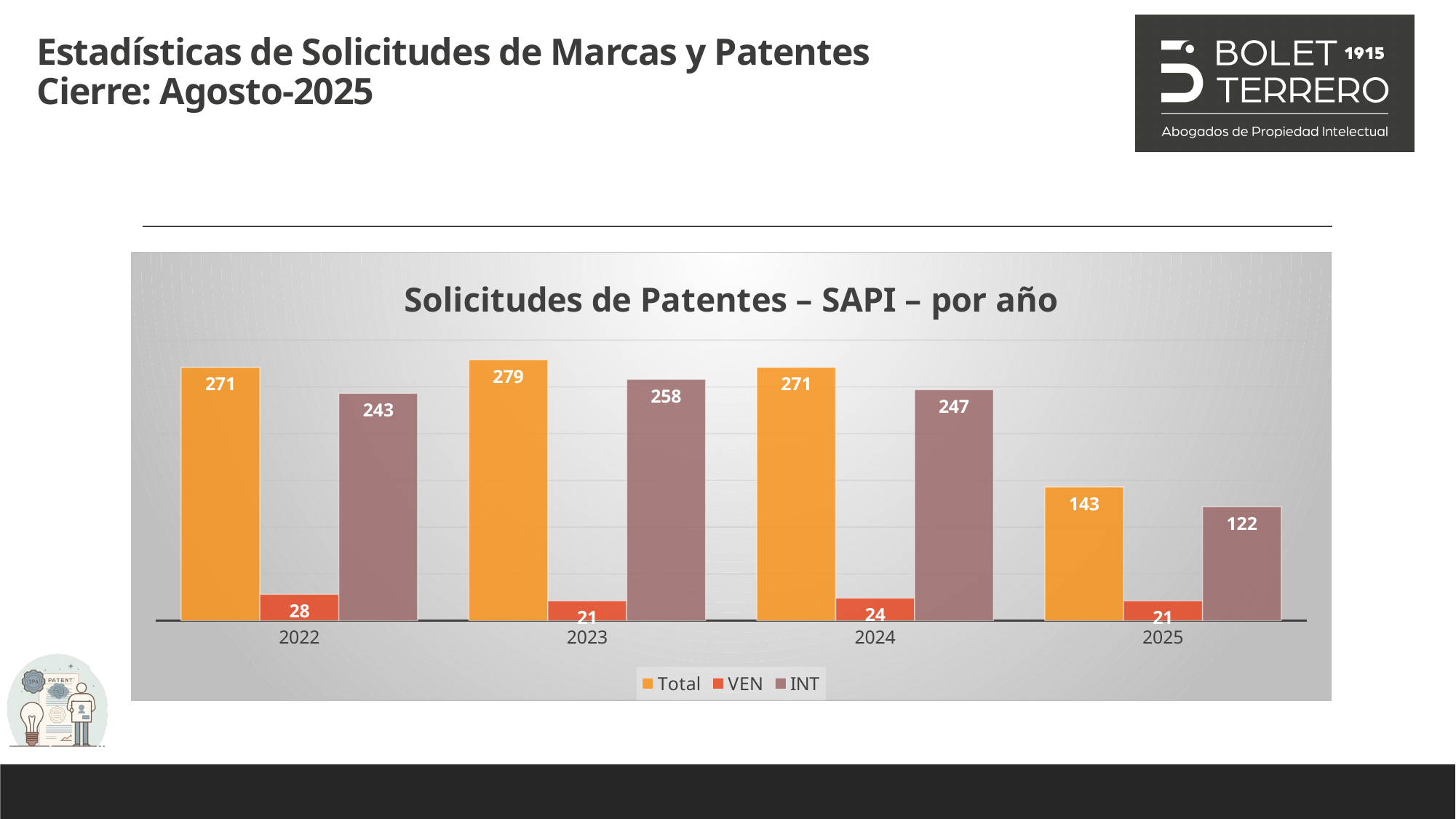
How many years are shown on the x axis? 4 Which year has the lowest INT value? 2025 How many series does the legend list? 3 Which is larger, the VEN value for 2022 or the VEN value for 2024? 2022 What is the VEN value for 2022? 28 What kind of chart is shown on the slide? Bar chart What is the INT value for 2025? 122 What is the difference between the INT values for 2023 and 2022? 15 Which year has the highest Total value? 2023 What is the Total value for 2023? 279 What is the INT value for 2024? 247 What is the difference between the Total values for 2024 and 2025? 128